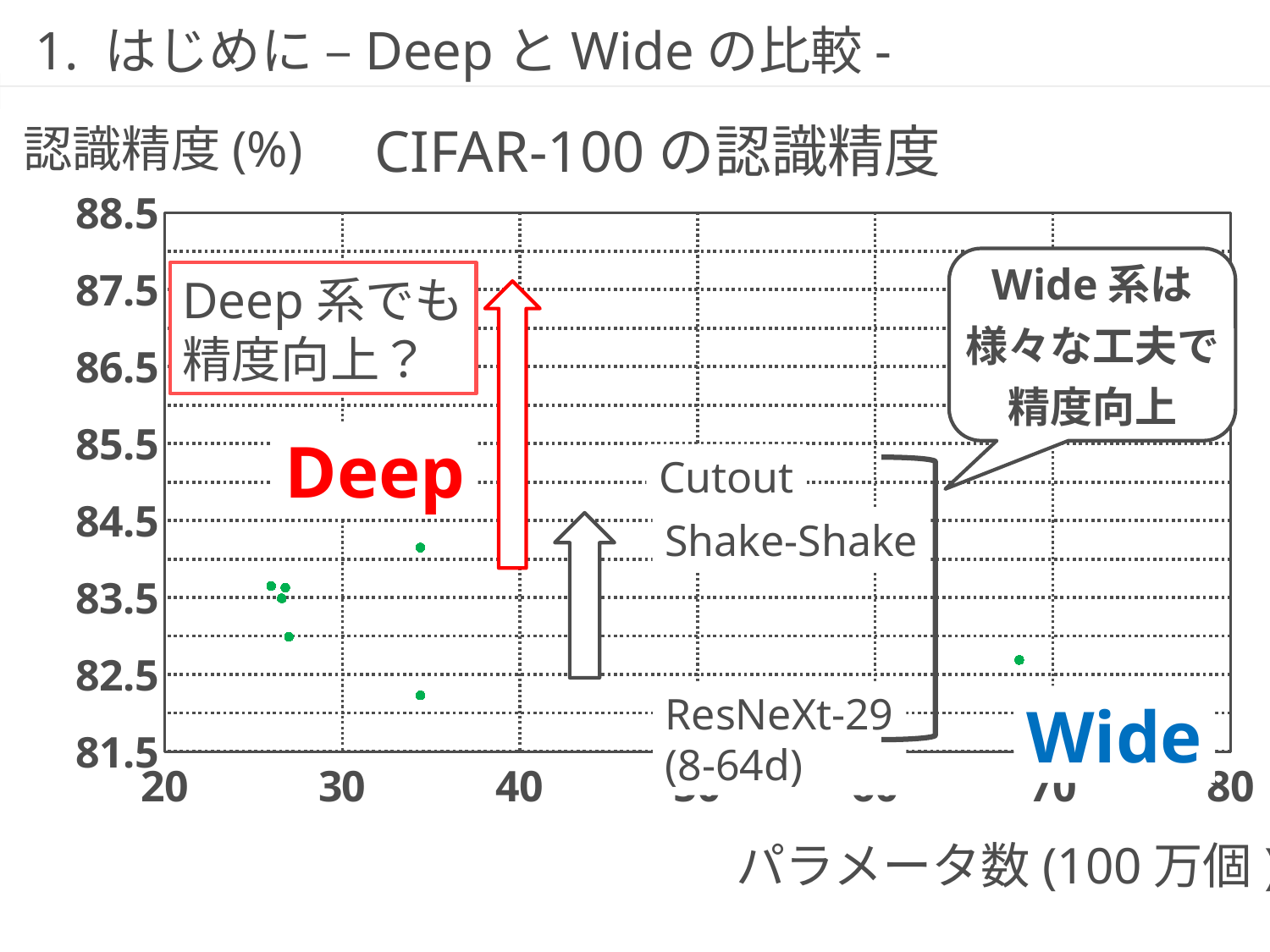
What is the highest value shown on the y axis? 88.5 Is the accuracy of the data point plotted near 68 on the x axis greater or less than 83.5? less How many data points are plotted on the chart? 7 Is the accuracy of the lowest data point greater or less than 82.5? less Which has the higher accuracy: the data point near 68 on the x axis or the highest data point near 35 on the x axis? the point near 35 Is the accuracy of the highest data point greater or less than 83.5? greater What is the label of the x axis? パラメータ数 (100 万個 ) What is the title of the chart? CIFAR-100 の認識精度 What kind of chart is shown on the slide? scatter chart